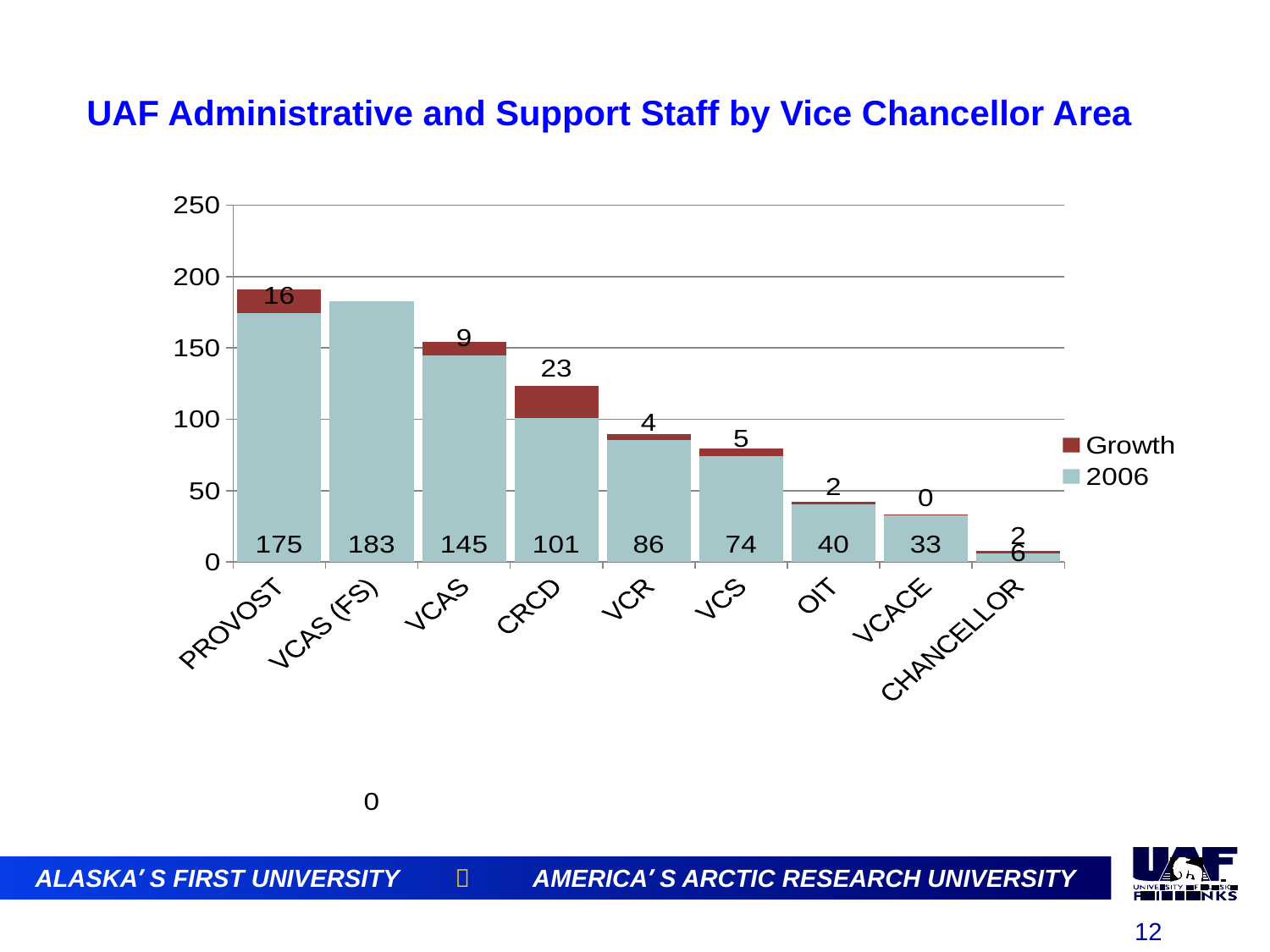
Which has a larger 2006 value, VCR or VCS? VCR Which category has the lowest 2006 value? CHANCELLOR What is the Growth value for CRCD? 23 Which category has the largest Growth value? CRCD What kind of chart is shown on the slide? Stacked bar chart How many categories are shown on the x axis? 9 What is the difference between the 2006 values for VCAS and CRCD? 44 Which category has the highest 2006 value? VCAS (FS) What is the total of the stacked bar for PROVOST (2006 plus Growth)? 191 How many series does the legend list? 2 What is the 2006 value for VCACE? 33 What is the 2006 value for PROVOST? 175